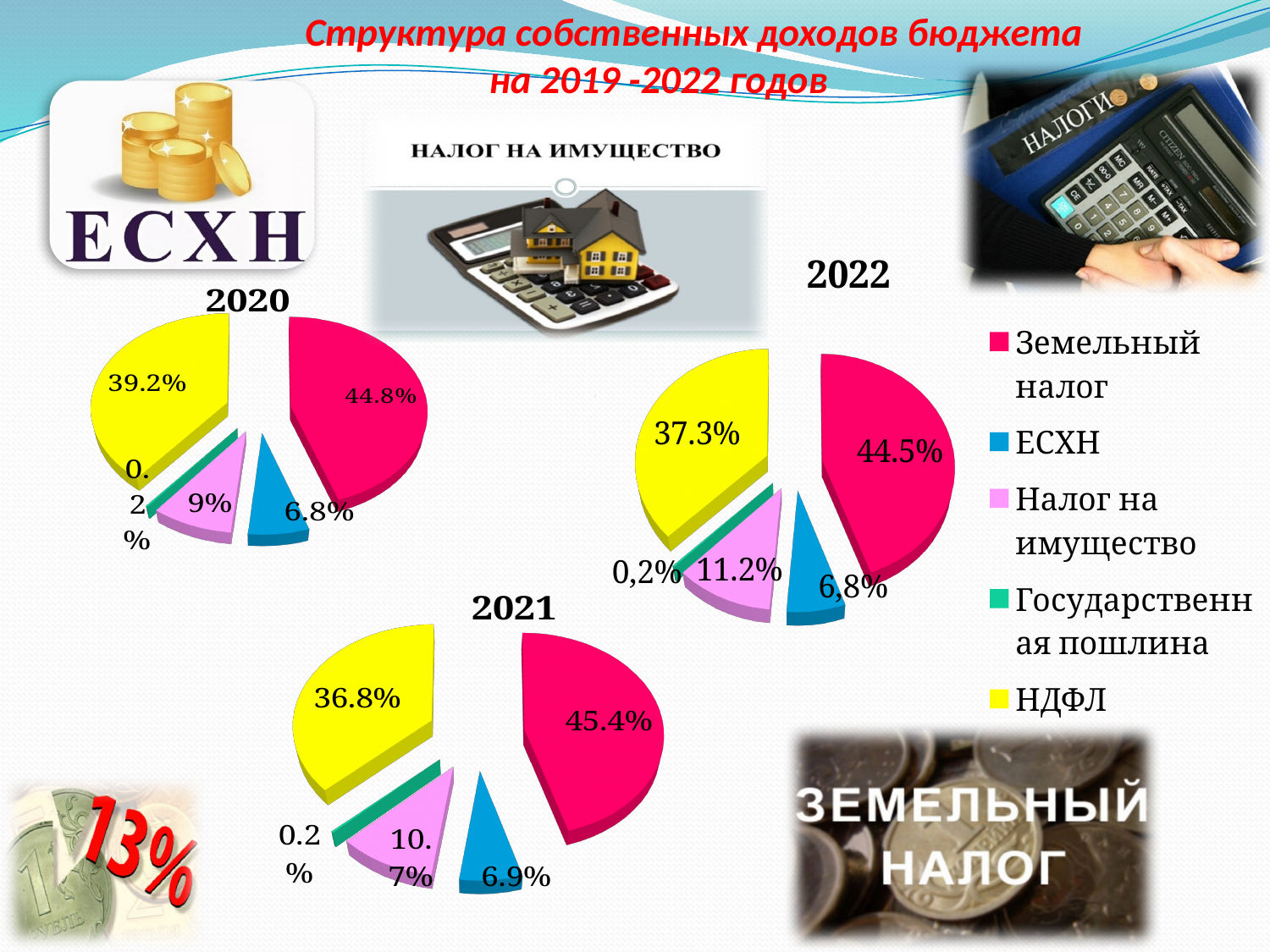
On the 2022 pie chart, what share does ЕСХН have? 6,8% On the 2021 pie chart, what is the difference between the shares of Земельный налог and НДФЛ? 8.6% On the 2022 pie chart, which is larger: the share of НДФЛ or the share of Налог на имущество? НДФЛ Which colour represents ЕСХН in the legend? Blue On the 2020 pie chart, what share does Земельный налог have? 44.8% On the 2020 pie chart, which category has the smallest share? Государственная пошлина On the 2021 pie chart, what share does НДФЛ have? 36.8% On the 2021 pie chart, which category has the largest share? Земельный налог What kind of chart is used for the 2020, 2021 and 2022 data? Pie chart How many series does the legend list? 5 How many pie charts are shown on the slide? 3 On the 2022 pie chart, what share does Налог на имущество have? 11.2%